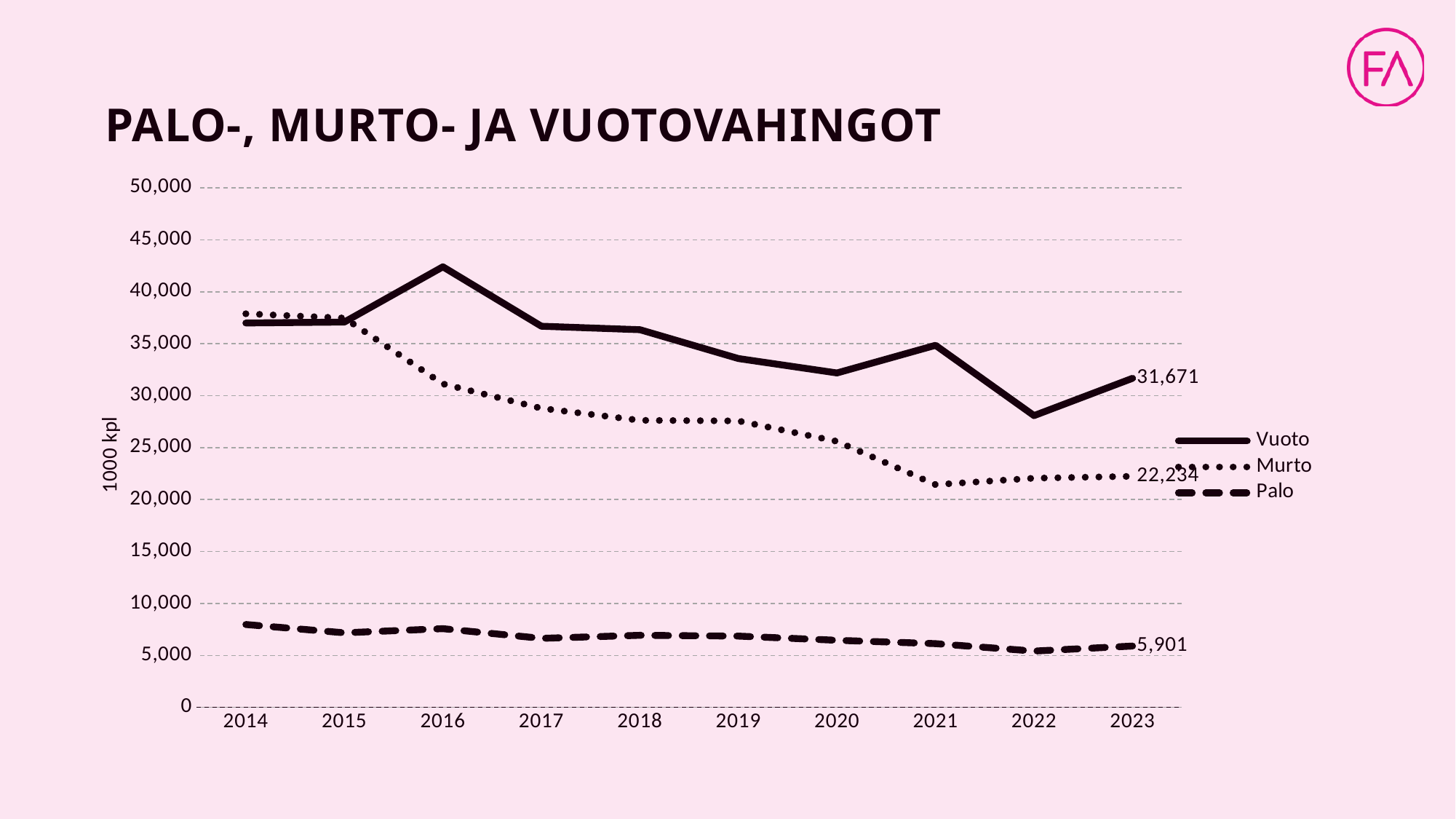
What is the value for Palo in 2023? 5,901 Which series has the larger value in 2023, Vuoto or Murto? Vuoto How many series does the legend list? 3 What is the value for Murto in 2023? 22,234 Is the value for Vuoto in 2016 greater or less than 40,000? greater What is the difference between the Murto and Palo values in 2023? 16,333 What is the difference between the Vuoto and Murto values in 2023? 9,437 What is the value for Vuoto in 2023? 31,671 In which year does the Vuoto series reach its highest value? 2016 Is the value for Murto in 2021 greater or less than 25,000? less What kind of chart is shown on the slide? line chart In which year does the Vuoto series reach its lowest value? 2022